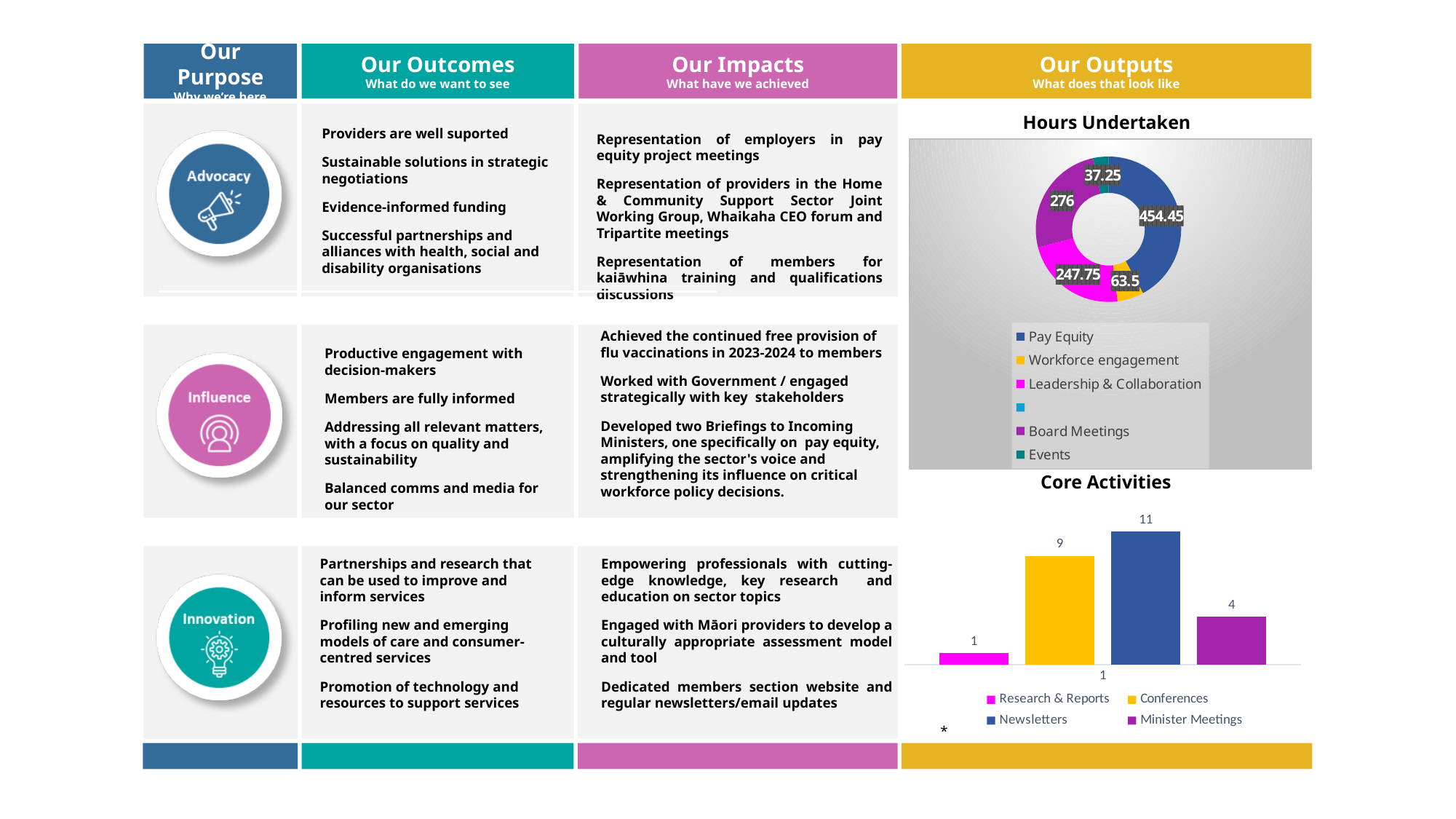
In the Hours Undertaken chart, how many hours are shown for Pay Equity? 454.45 In the Hours Undertaken chart, which category has the most hours? Pay Equity In the Core Activities chart, which category has the lowest value? Research & Reports In the Hours Undertaken chart, what is the difference between Pay Equity and Workforce engagement? 390.95 In the Hours Undertaken chart, which is larger: Leadership & Collaboration or Board Meetings? Board Meetings How many bars are plotted in the Core Activities chart? 4 In the Core Activities chart, what is the value for Newsletters? 11 In the Hours Undertaken chart, what value is shown for Events? 37.25 In the Core Activities chart, what is the difference between Newsletters and Minister Meetings? 7 In the Core Activities chart, what is the value for Conferences? 9 What kind of chart is the Hours Undertaken chart? Doughnut (pie) chart In the Hours Undertaken chart, what value is shown for Board Meetings? 276